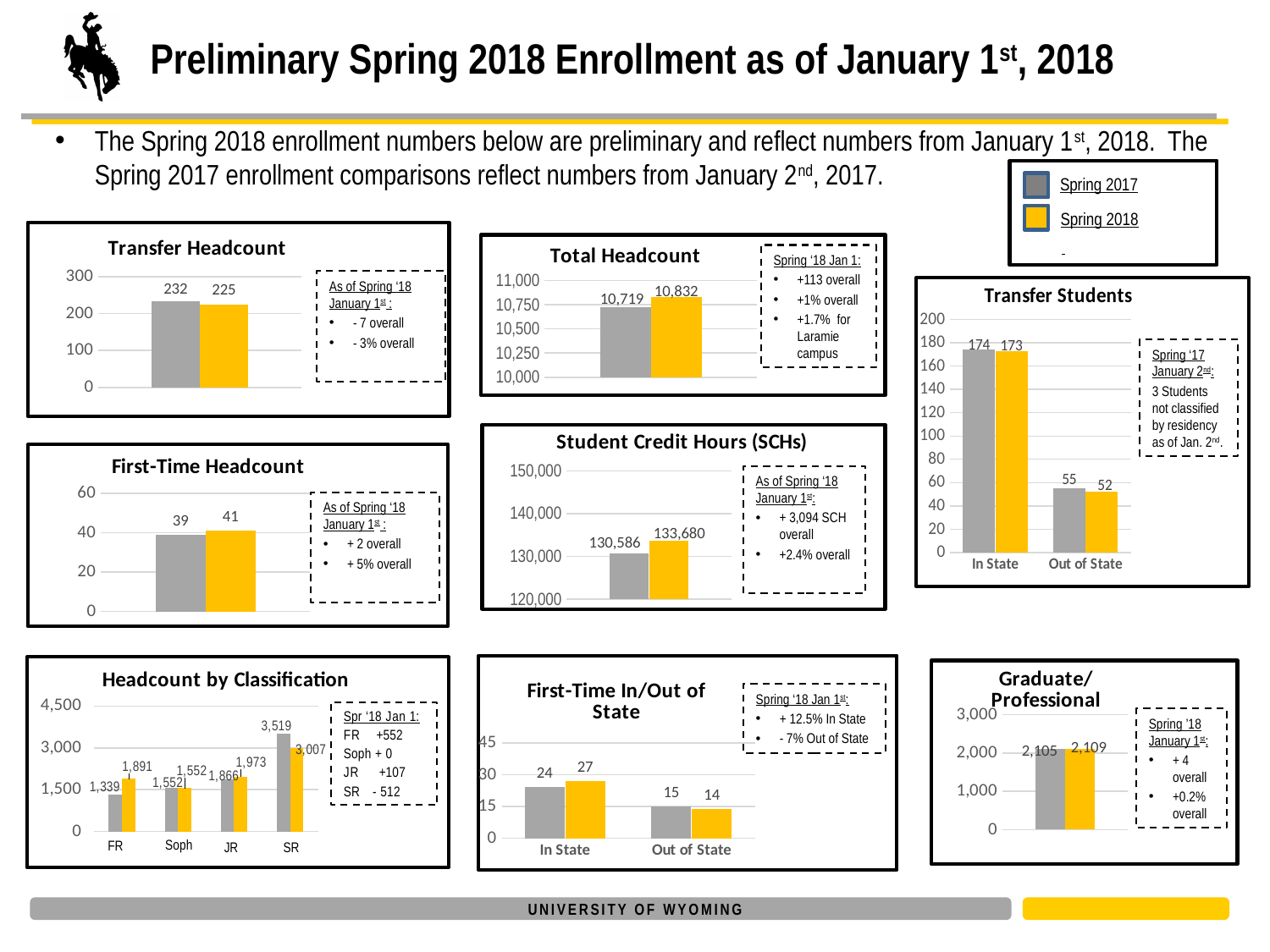
In the Headcount by Classification chart, what is the Spring 2018 value for JR? 1,973 In the First-Time Headcount chart, what is the difference between the Spring 2018 and Spring 2017 values? 2 In the Graduate/Professional chart, what is the value for Spring 2018? 2,109 In the Student Credit Hours (SCHs) chart, what is the difference between the Spring 2018 and Spring 2017 values? 3,094 In the First-Time In/Out of State chart, which is larger: the Spring 2018 value for In State or the Spring 2018 value for Out of State? In State What type of chart is the Transfer Students chart? Bar chart In the Total Headcount chart, what is the value for Spring 2017? 10,719 In the Transfer Headcount chart, what is the value for Spring 2018? 225 How many series does the legend at the top right of the slide list? 2 In the Headcount by Classification chart, which classification has the highest Spring 2017 value? SR In the Transfer Students chart, what is the Spring 2018 value for Out of State? 52 In the Headcount by Classification chart, how many classification categories are shown on the x axis? 4